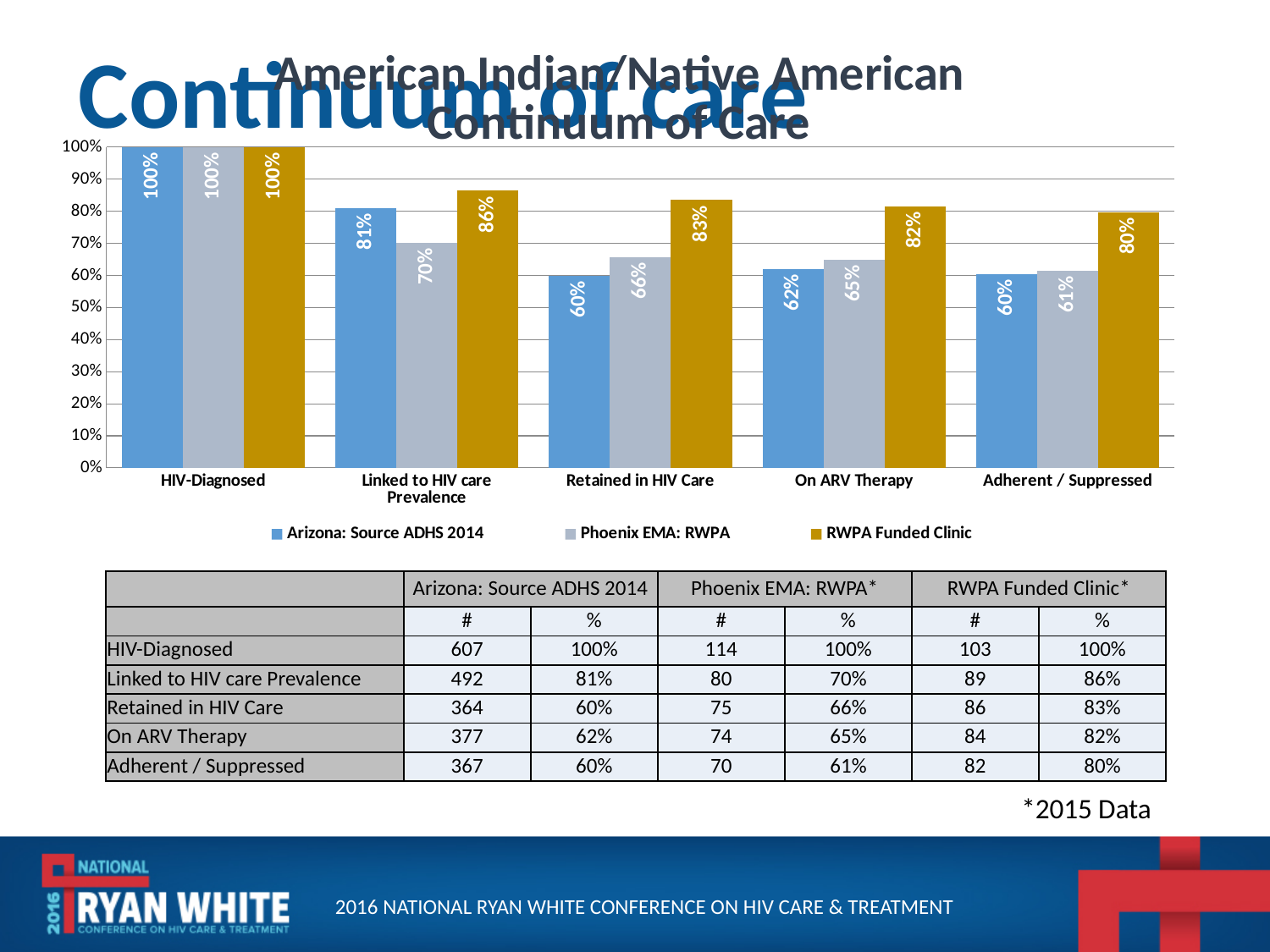
What is the value for Arizona: Source ADHS 2014 in the On ARV Therapy category? 62% Which is larger in the Retained in HIV Care category: Arizona: Source ADHS 2014 or Phoenix EMA: RWPA? Phoenix EMA: RWPA What is the title of the chart? American Indian/Native American Continuum of Care What is the value for RWPA Funded Clinic in the Retained in HIV Care category? 83% How many categories are shown on the x axis? 5 Do the values for the Arizona: Source ADHS 2014 series generally rise or fall from HIV-Diagnosed to Adherent / Suppressed? Fall Which category has the lowest value for the Phoenix EMA: RWPA series? Adherent / Suppressed What is the value for Phoenix EMA: RWPA in the Linked to HIV care Prevalence category? 70% Which series has the highest value in the Adherent / Suppressed category? RWPA Funded Clinic What kind of chart is shown on the slide? Bar chart What is the difference between the RWPA Funded Clinic and Arizona: Source ADHS 2014 values in the Linked to HIV care Prevalence category? 5% How many series does the legend list? 3